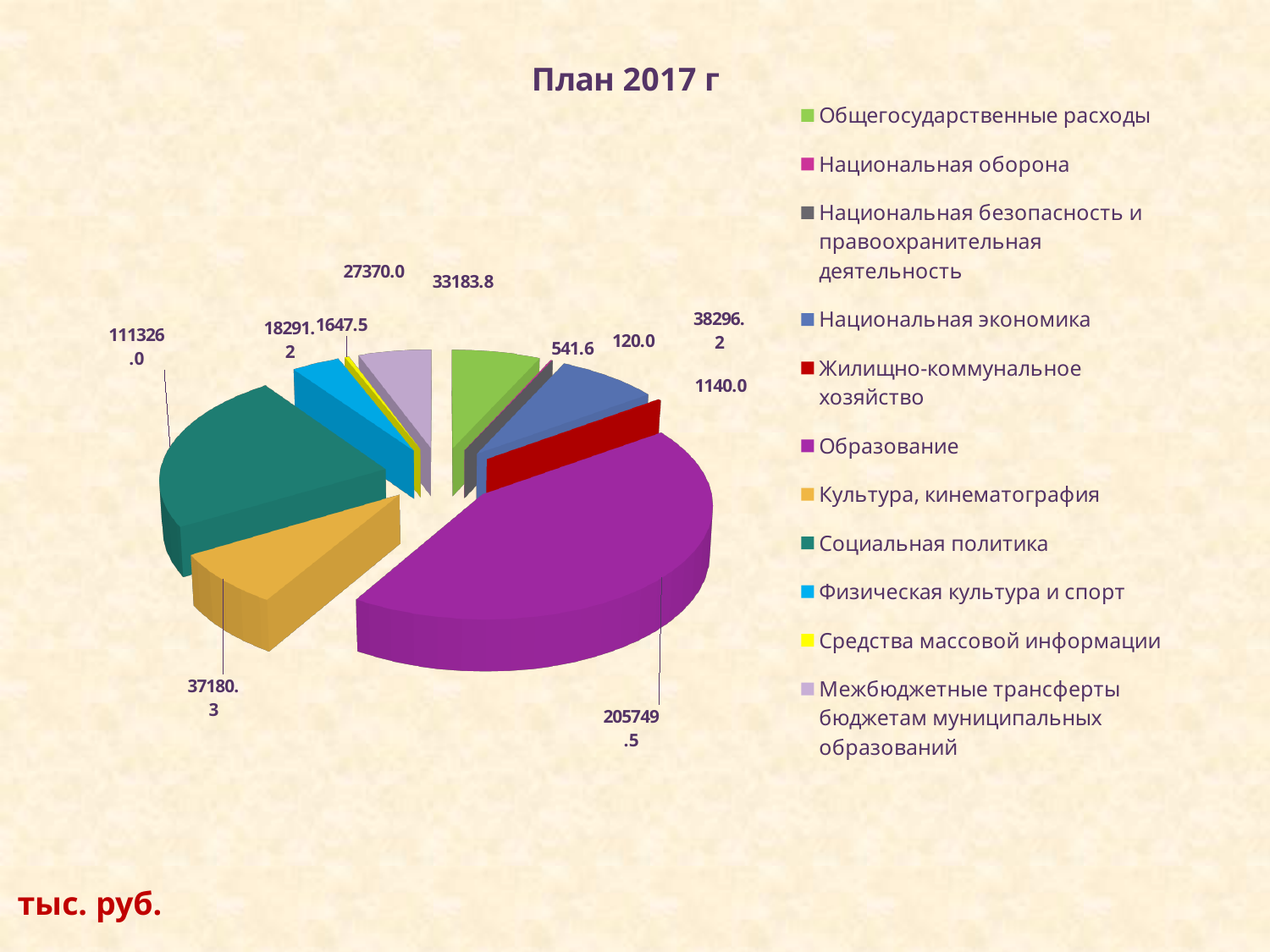
What is the value for Культура, кинематография? 37180.3 What is the difference between the values for Образование and Социальная политика? 94423.5 What is the title of the chart? План 2017 г Which category has the largest slice of the pie? Образование What is the value for Национальная экономика? 38296.2 What is the value for Физическая культура и спорт? 18291.2 What kind of chart is shown on the slide? pie chart How many categories does the legend list? 11 What is the value for Социальная политика? 111326.0 What is the value for Межбюджетные трансферты бюджетам муниципальных образований? 27370.0 Which is larger, the value for Национальная экономика or the value for Культура, кинематография? Национальная экономика What is the value for Образование? 205749.5